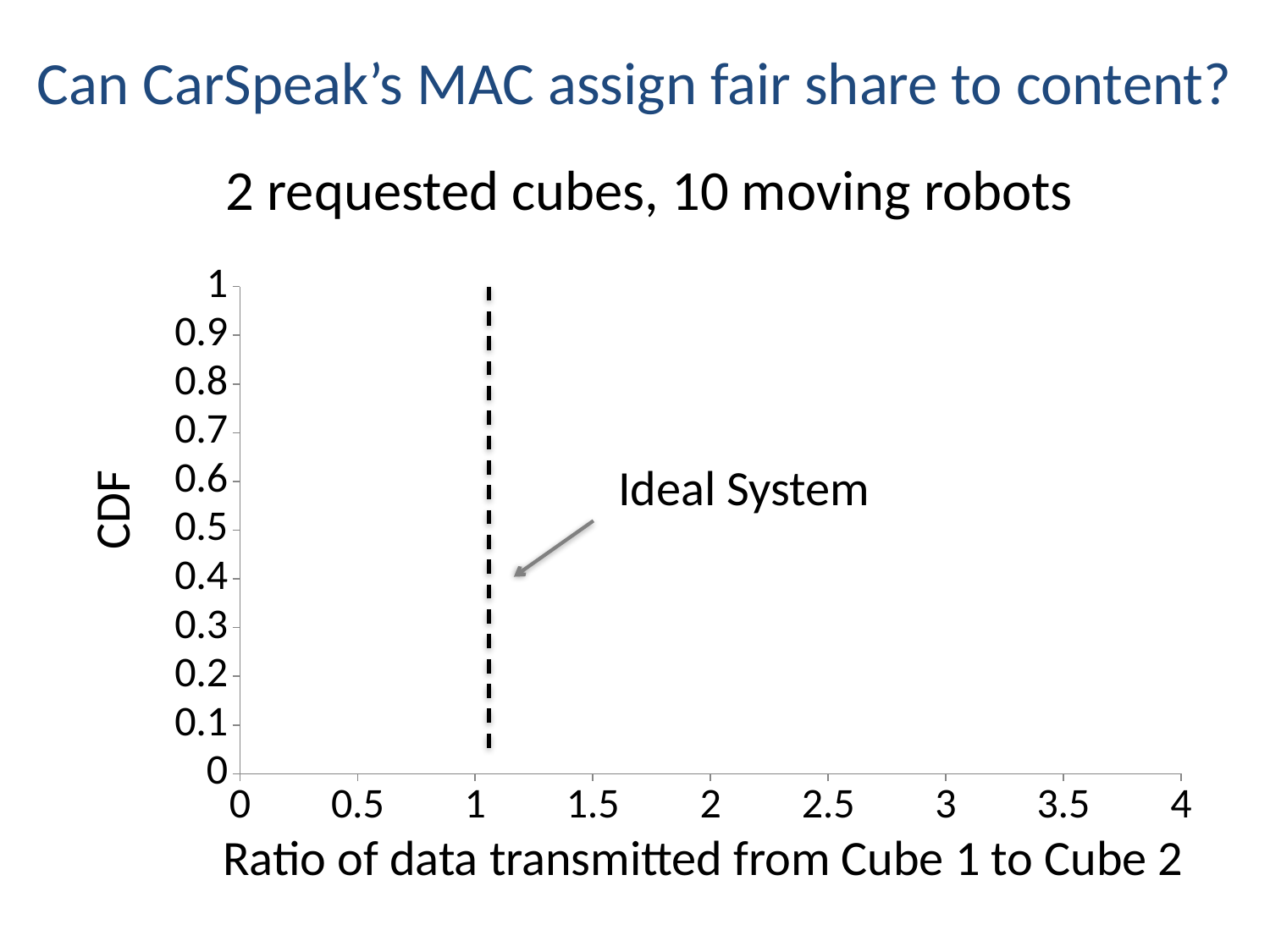
Is the ratio at which the Ideal System dashed line is drawn greater or less than 2? less What does the dashed vertical line on the chart represent? Ideal System What is the label of the x axis of the chart? Ratio of data transmitted from Cube 1 to Cube 2 Is the ratio at which the Ideal System dashed line is drawn greater or less than 0.5? greater